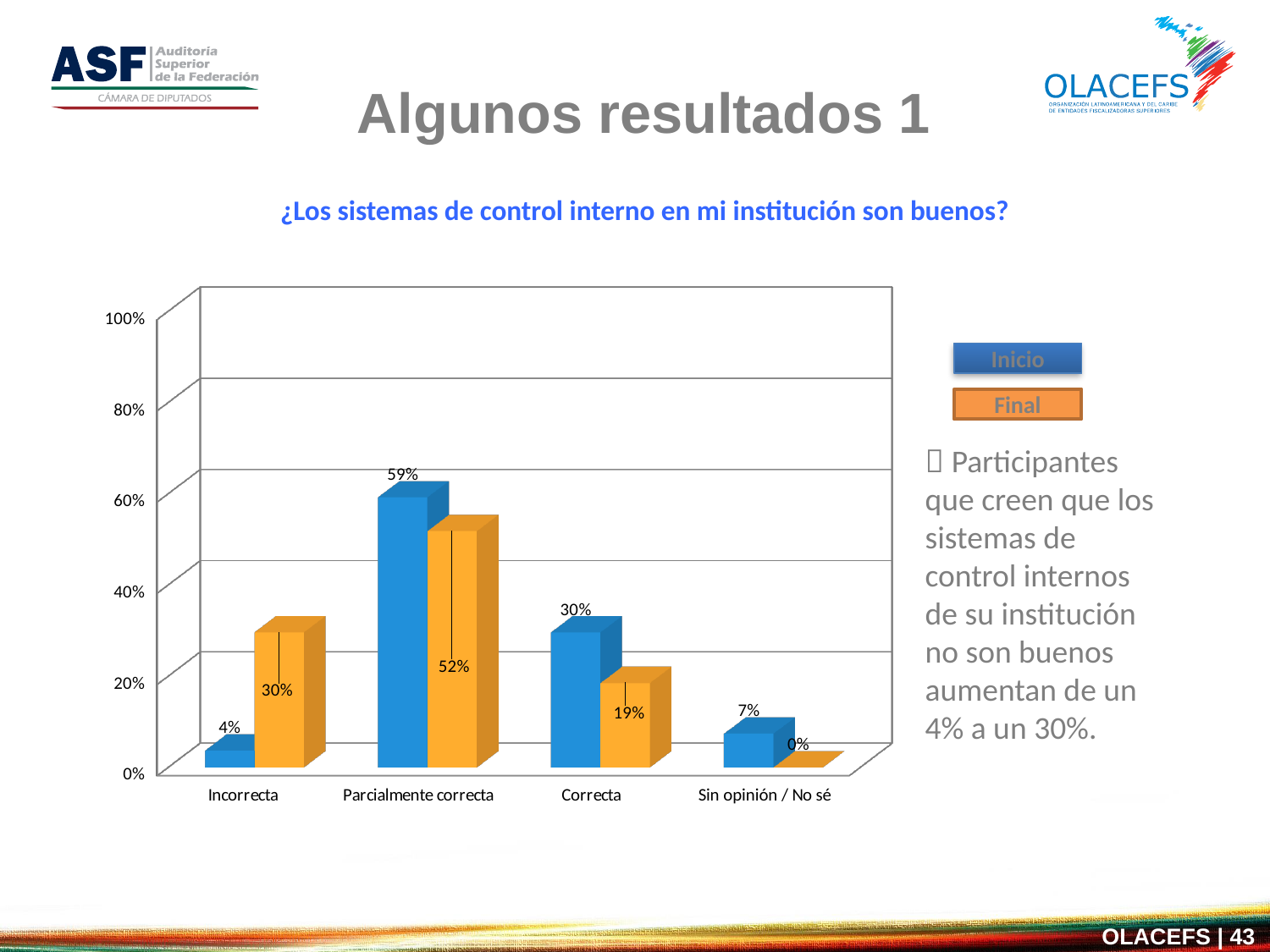
What is the difference between the Inicio and Final values for Correcta? 11% What is the Final value for Incorrecta? 30% How many categories are shown on the x axis? 4 Which category has the highest Inicio value? Parcialmente correcta Which is larger for Incorrecta, the Inicio value or the Final value? Final What is the Inicio value for Parcialmente correcta? 59% Which category has the lowest Final value? Sin opinión / No sé How many series does the legend list? 2 What kind of chart is shown on the slide? Bar chart What is the Inicio value for Incorrecta? 4% What is the Final value for Correcta? 19% What question is the chart about, as shown in the title above it? ¿Los sistemas de control interno en mi institución son buenos?